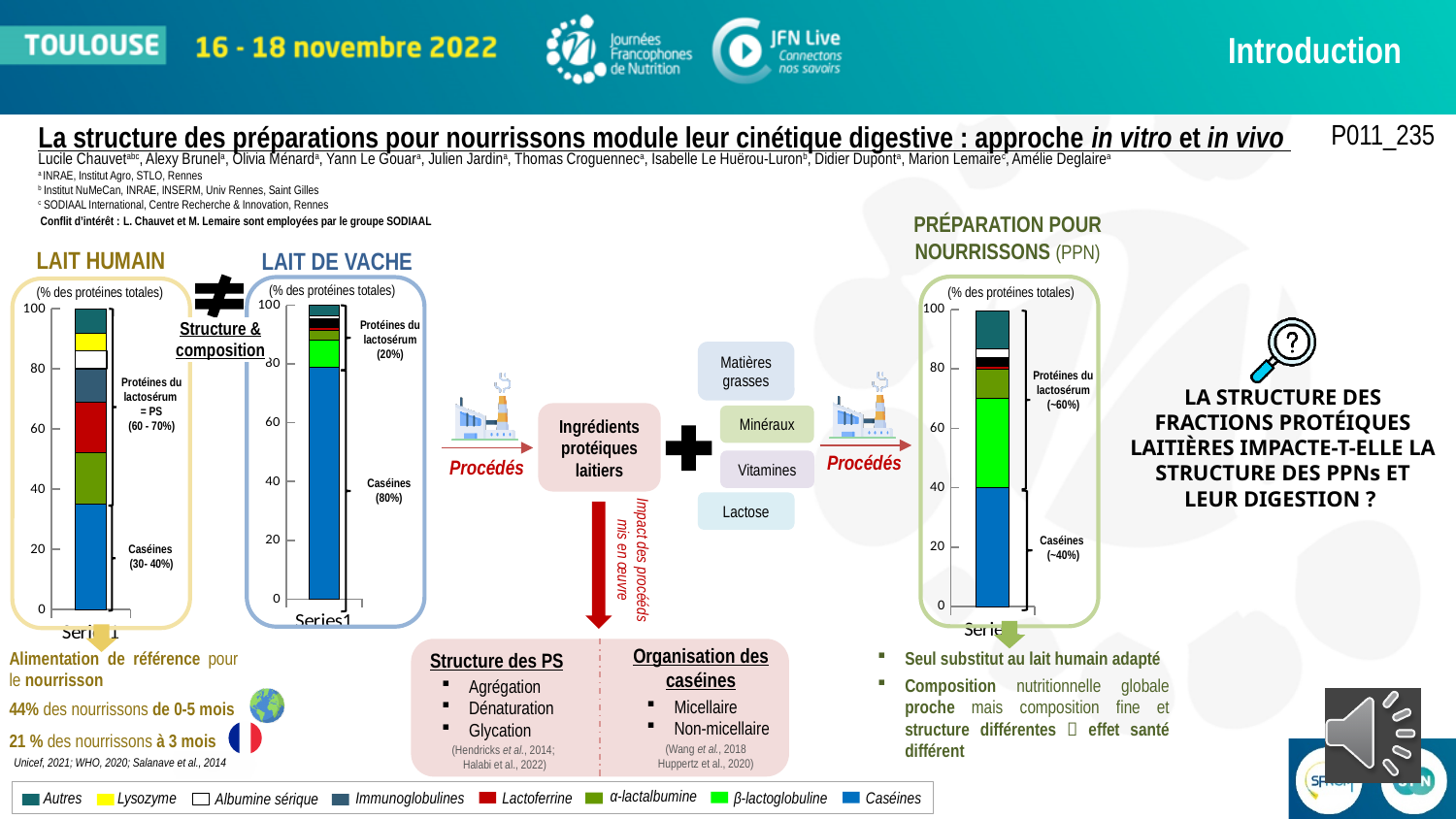
How many series does the shared legend at the bottom of the slide list? 8 In the PPN chart, is the value for Caséines greater or less than 20? greater How many bar charts are shown on the slide? 3 What is the maximum value shown on the y axis of the LAIT HUMAIN chart? 100 In the LAIT DE VACHE chart, is the value for Caséines greater or less than 60? greater What kind of chart is used for the LAIT HUMAIN, LAIT DE VACHE and PPN charts? Stacked bar chart Which chart shows the larger Caséines segment, LAIT HUMAIN or LAIT DE VACHE? LAIT DE VACHE Across the three charts, which one has the largest Caséines segment? LAIT DE VACHE Which chart shows the larger Caséines segment, LAIT DE VACHE or PPN? LAIT DE VACHE In the legend, which series is shown in red? Lactoferrine In the LAIT HUMAIN chart, is the value for Caséines greater or less than 40? less What unit is indicated above the bars in each of the three charts? % des protéines totales